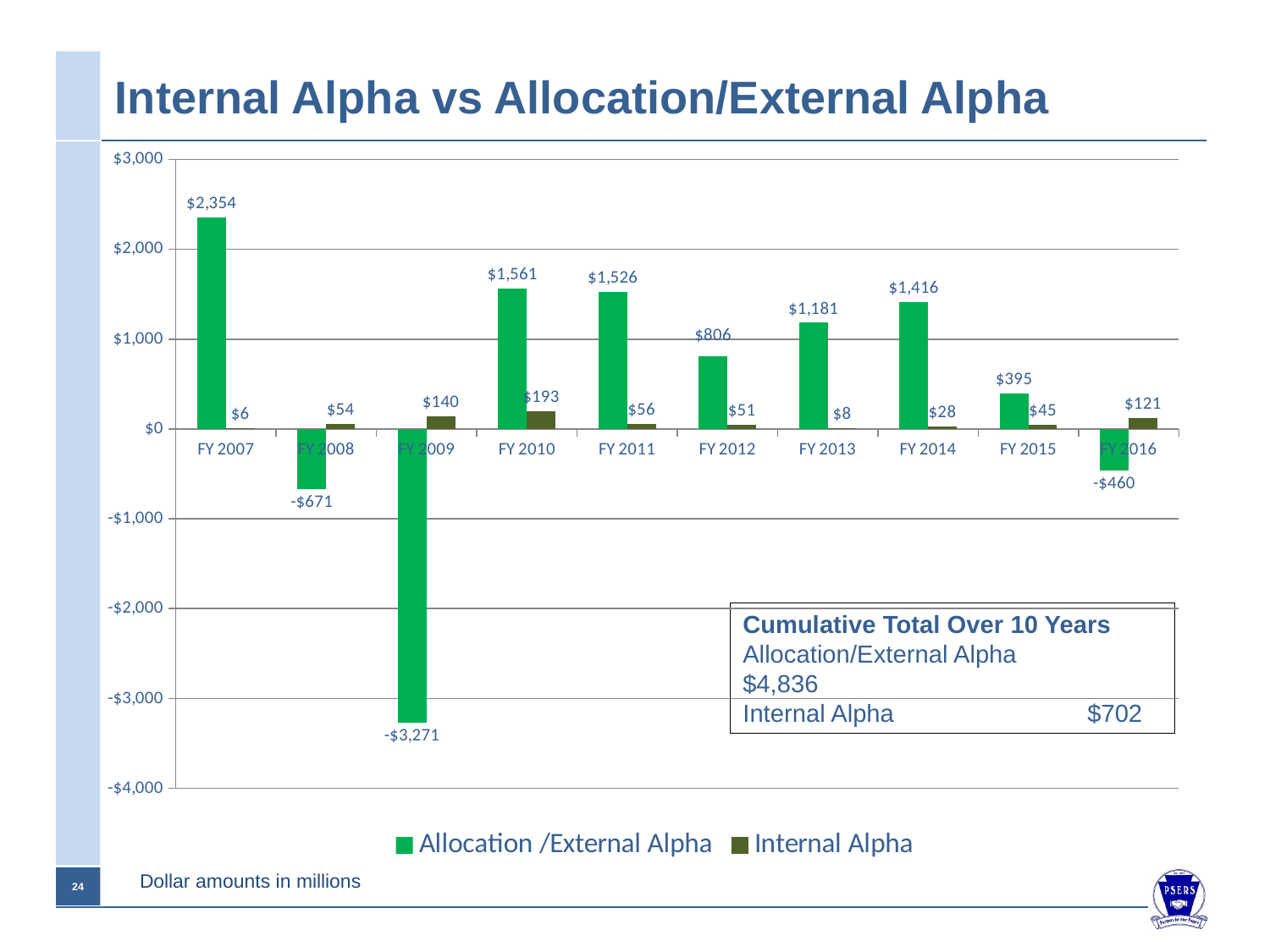
Which fiscal year has the lowest Allocation/External Alpha value? FY 2009 What is the difference between the Allocation/External Alpha values for FY 2010 and FY 2011? $35 Which fiscal year has the lowest Internal Alpha value? FY 2007 Which is larger, the Internal Alpha value for FY 2015 or for FY 2016? FY 2016 How many fiscal years are shown on the x axis? 10 What is the Allocation/External Alpha value for FY 2009? -$3,271 Which fiscal year has the highest Allocation/External Alpha value? FY 2007 How many series does the legend list? 2 What kind of chart is shown on the slide? Bar chart What is the Allocation/External Alpha value for FY 2007? $2,354 What is the cumulative total over 10 years for Internal Alpha shown in the text box? $702 What is the Internal Alpha value for FY 2010? $193